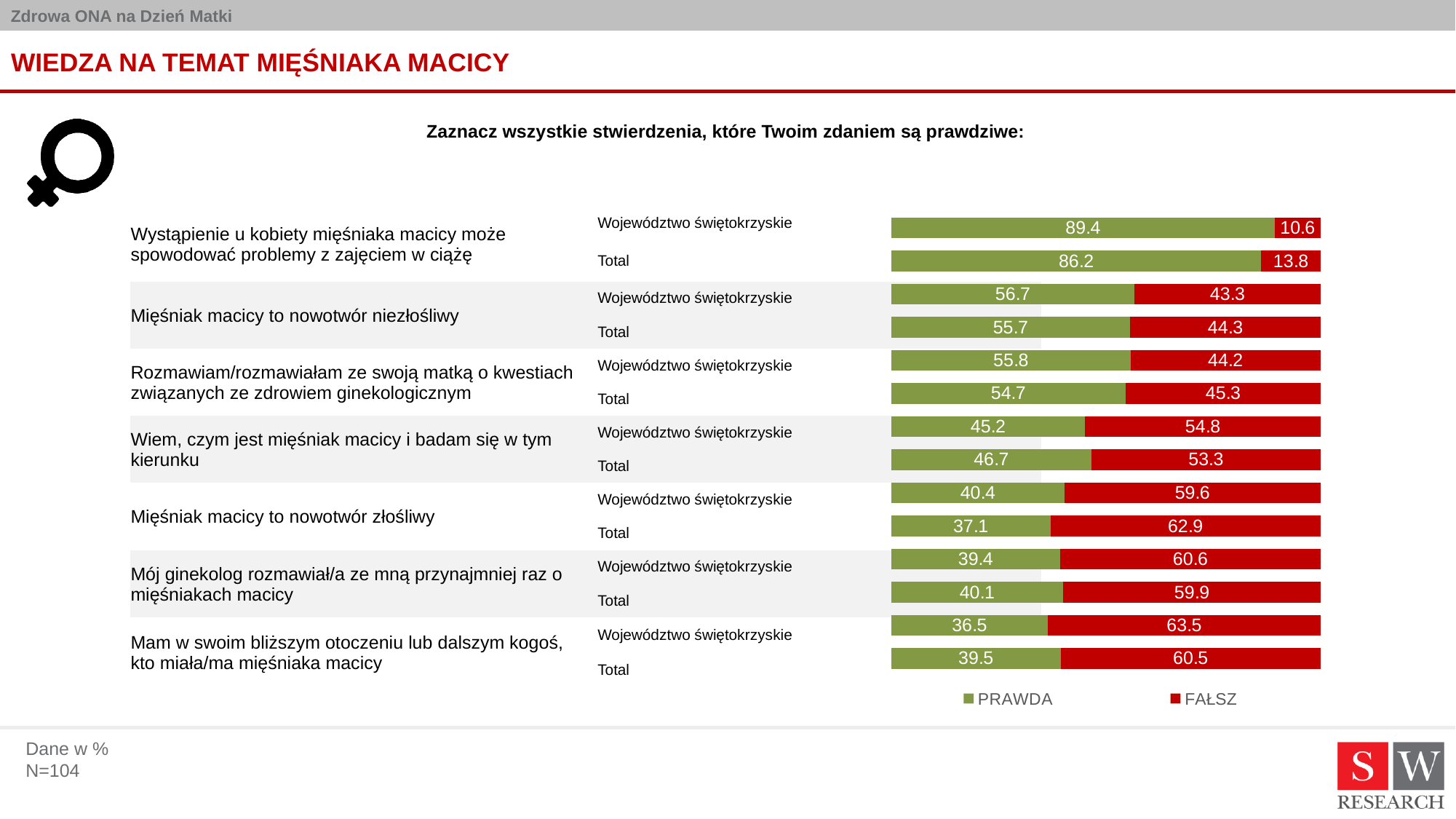
For the statement "Wiem, czym jest mięśniak macicy i badam się w tym kierunku", which is larger: the PRAWDA value for "Województwo świętokrzyskie" or for "Total"? Total What is the difference between the PRAWDA values for "Województwo świętokrzyskie" and "Total" for the statement "Mięśniak macicy to nowotwór złośliwy"? 3.3 What type of chart is shown on the slide? Stacked bar chart Which colour represents the FAŁSZ series in the chart? Red What is the FAŁSZ value for "Total" for the statement "Mięśniak macicy to nowotwór niezłośliwy"? 44.3 Which statement has the highest PRAWDA value for "Województwo świętokrzyskie"? Wystąpienie u kobiety mięśniaka macicy może spowodować problemy z zajęciem w ciążę How many series does the legend list? 2 What is the PRAWDA value for "Województwo świętokrzyskie" for the statement "Wystąpienie u kobiety mięśniaka macicy może spowodować problemy z zajęciem w ciążę"? 89.4 What is the PRAWDA value for "Total" for the statement "Mam w swoim bliższym otoczeniu lub dalszym kogoś, kto miała/ma mięśniaka macicy"? 39.5 How many statements are shown in the chart? 7 Which statement has the lowest PRAWDA value for "Województwo świętokrzyskie"? Mam w swoim bliższym otoczeniu lub dalszym kogoś, kto miała/ma mięśniaka macicy What is the total of the stacked bar for "Total" for the statement "Mój ginekolog rozmawiał/a ze mną przynajmniej raz o mięśniakach macicy"? 100